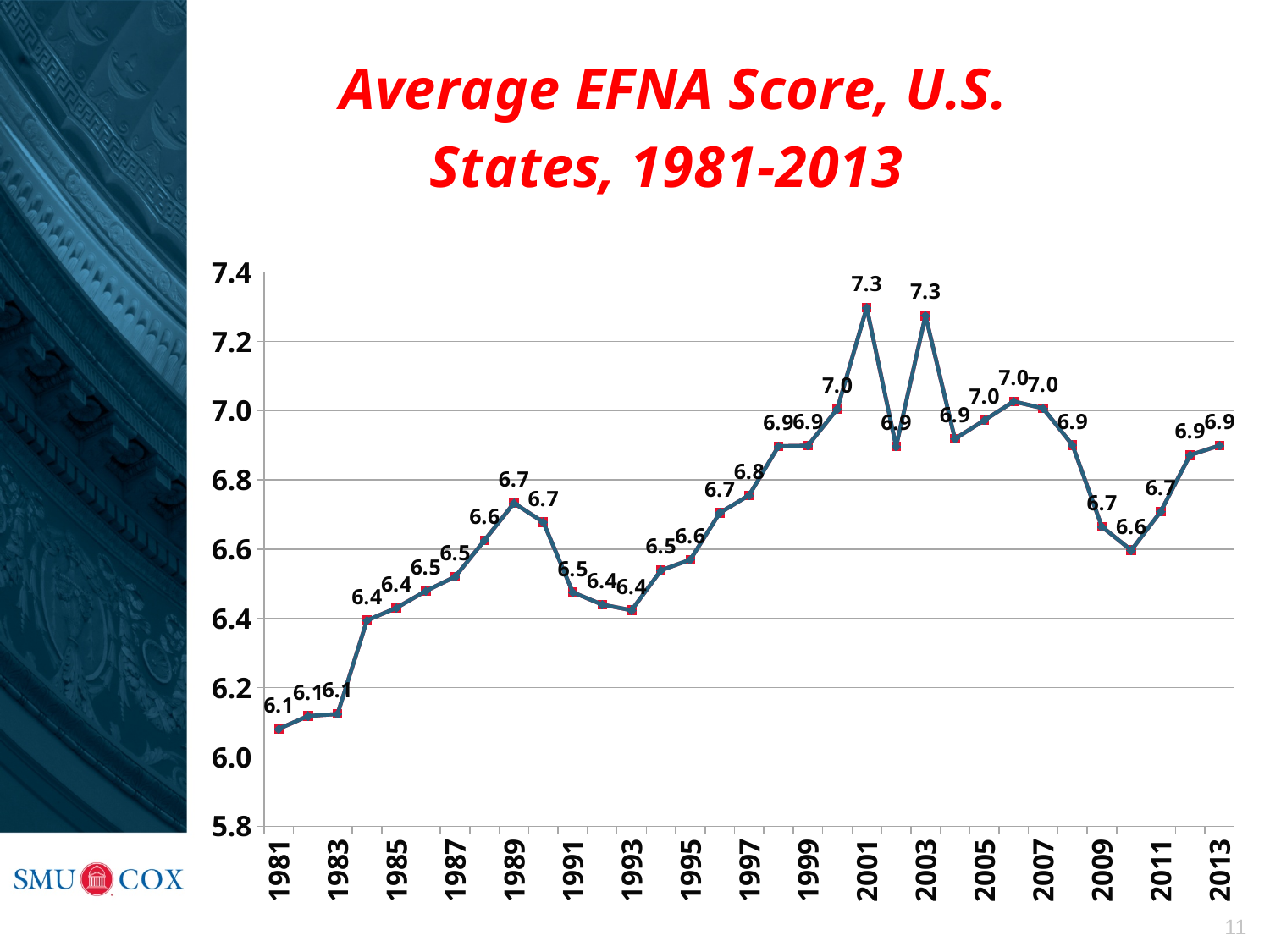
What is the average EFNA score for 2013? 6.9 What is the average EFNA score for 2001? 7.3 What is the average EFNA score for 1989? 6.7 What is the average EFNA score for 2010? 6.6 What kind of chart is shown on the slide? line chart What is the lowest average EFNA score shown on the chart? 6.1 Do the average EFNA scores rise or fall from 1981 to 1989? rise What is the difference between the average EFNA score in 2001 and in 1981? 1.2 Is the average EFNA score for 2001 greater or less than 7.2? greater What is the highest average EFNA score shown on the chart? 7.3 Which year has the higher average EFNA score, 1989 or 1993? 1989 What is the title of the chart? Average EFNA Score, U.S. States, 1981-2013